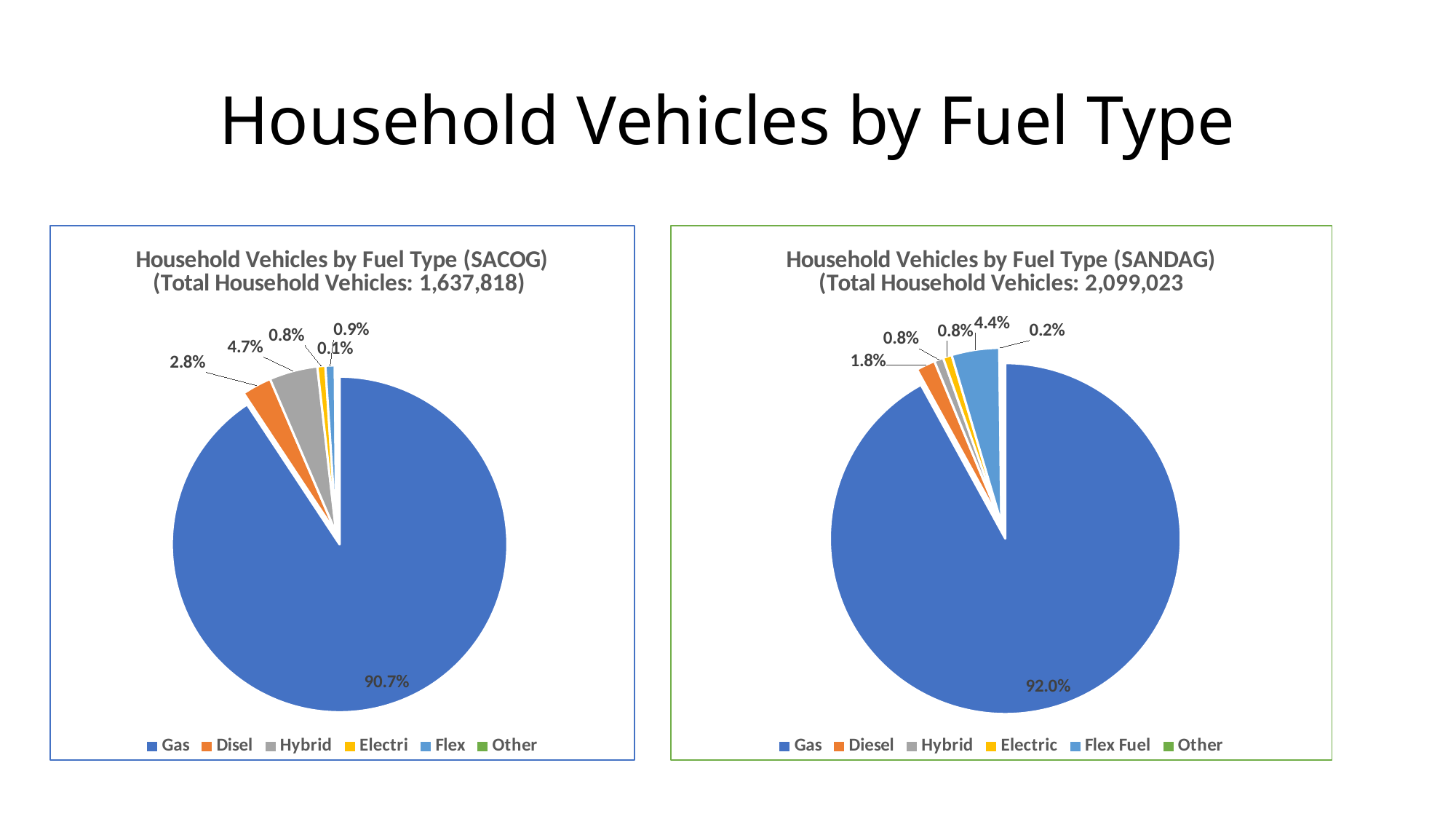
In the SACOG chart, what share of household vehicles is Diesel? 2.8% In the SANDAG chart, which fuel type has the largest share? Gas In the SACOG chart, what share of household vehicles is Hybrid? 4.7% In the SANDAG chart, what share of household vehicles is Flex Fuel? 4.4% In the SANDAG chart, what share of household vehicles is Diesel? 1.8% In the SANDAG chart, what share of household vehicles is Other? 0.2% In the SACOG chart, which is larger, the Hybrid share or the Diesel share? Hybrid How many fuel types does the legend of the SANDAG chart list? 6 In the SANDAG chart, what share of household vehicles is Gas? 92.0% What is the difference between the Gas share in the SANDAG chart and the Gas share in the SACOG chart? 1.3% What kind of chart is the Household Vehicles by Fuel Type (SACOG) chart? pie chart In the SACOG chart, what share of household vehicles is Gas? 90.7%